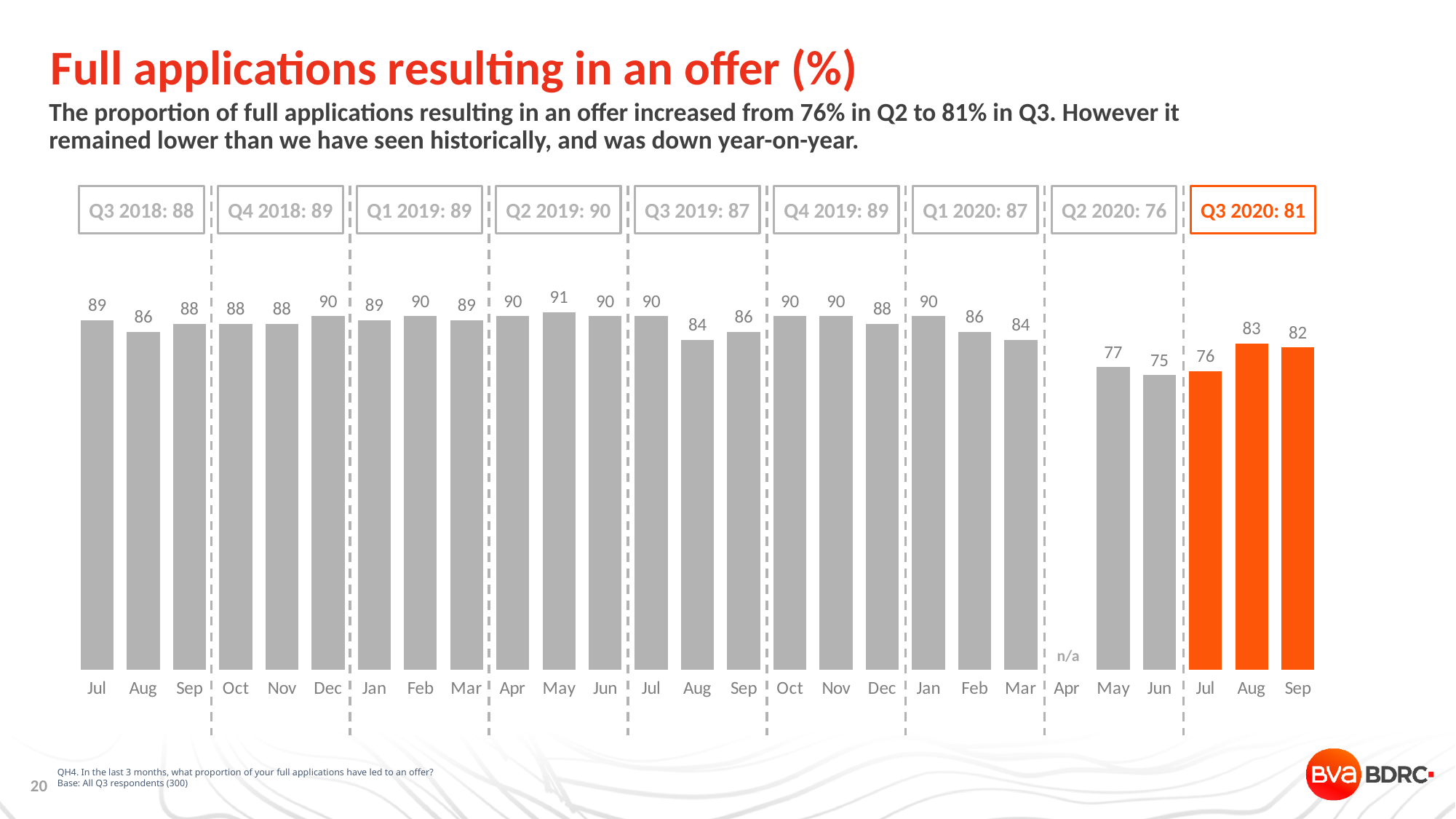
What quarterly value is shown in the box labelled Q2 2020? 76 Which is larger: the Sep value in Q3 2019 or the Sep value in Q3 2020? Sep in Q3 2019 (86) What is the difference between the Aug and Jul values in the Q3 2020 section? 7 Which month is marked as n/a on the chart? Apr (Q2 2020) Which month has the lowest value on the chart? Jun (Q2 2020), 75 Which month has the highest value on the chart? May (Q2 2019), 91 What is the value for Jun in the Q2 2020 section of the chart? 75 What type of chart is shown on the slide? Bar chart Do the values fall or rise from May to Jun in the Q2 2020 section? Fall What is the value for May in the Q2 2019 section of the chart? 91 What is the value for Aug in the Q3 2020 section of the chart? 83 How many month labels are shown along the x axis? 27